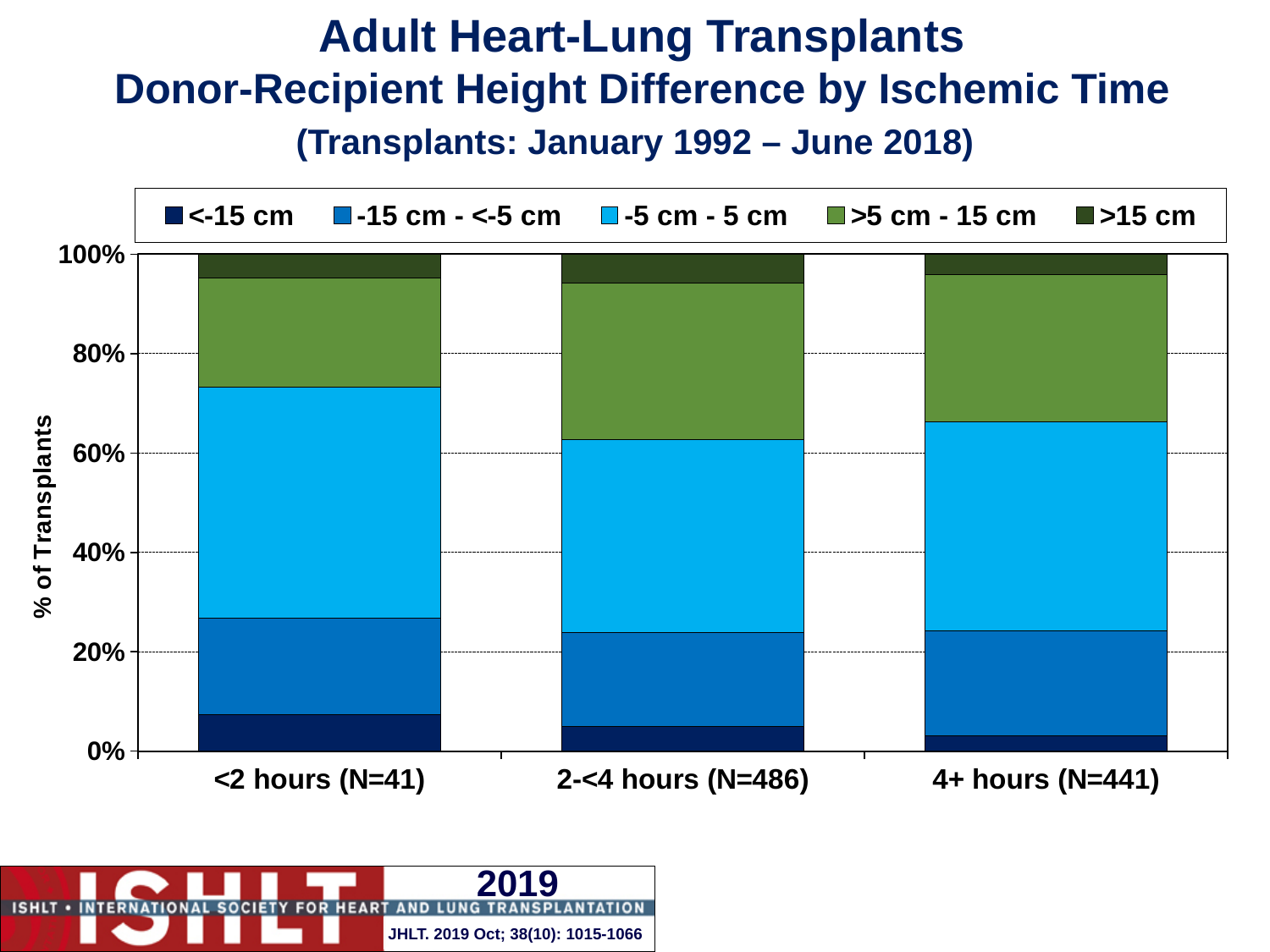
What kind of chart is shown on the slide? Stacked bar chart How many transplants (N) are in the 2-<4 hours category? 486 Is the share of the <-15 cm segment for <2 hours greater or less than 20%? less How many series does the legend list? 5 Which ischemic time category has the smallest <-15 cm segment? 4+ hours (N=441) Is the >5 cm - 15 cm segment larger for <2 hours or for 2-<4 hours? 2-<4 hours What is the label of the y axis? % of Transplants How many ischemic time categories are shown on the x axis? 3 How many transplants (N) are in the <2 hours category? 41 Which ischemic time category has the largest -5 cm - 5 cm segment? <2 hours (N=41) Is the share of the -5 cm - 5 cm segment for <2 hours greater or less than 40%? greater Is the share of the >5 cm - 15 cm segment for 2-<4 hours greater or less than 20%? greater